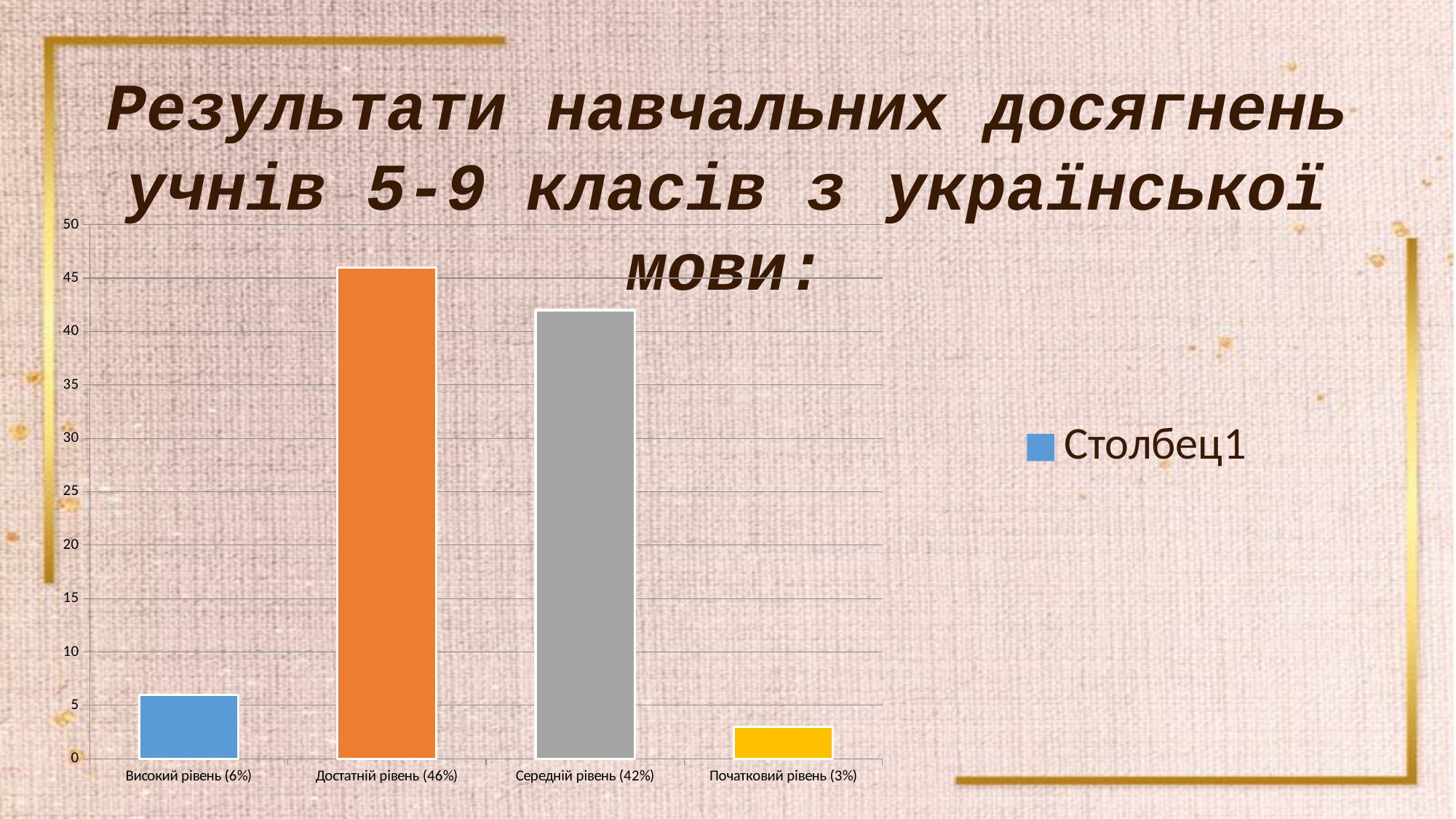
What percentage is shown for Високий рівень? 6% Which category has the highest bar? Достатній рівень What is the name of the series shown in the legend? Столбец1 How many series does the legend list? 1 What percentage is shown for Початковий рівень? 3% What percentage is shown for Достатній рівень? 46% How many categories are plotted in the chart? 4 What is the difference between the values for Достатній рівень and Середній рівень? 4% Is the value for Середній рівень greater or less than 40? greater Which category has the lowest bar? Початковий рівень Which is larger, the value for Високий рівень or the value for Початковий рівень? Високий рівень What kind of chart is shown on the slide? bar chart